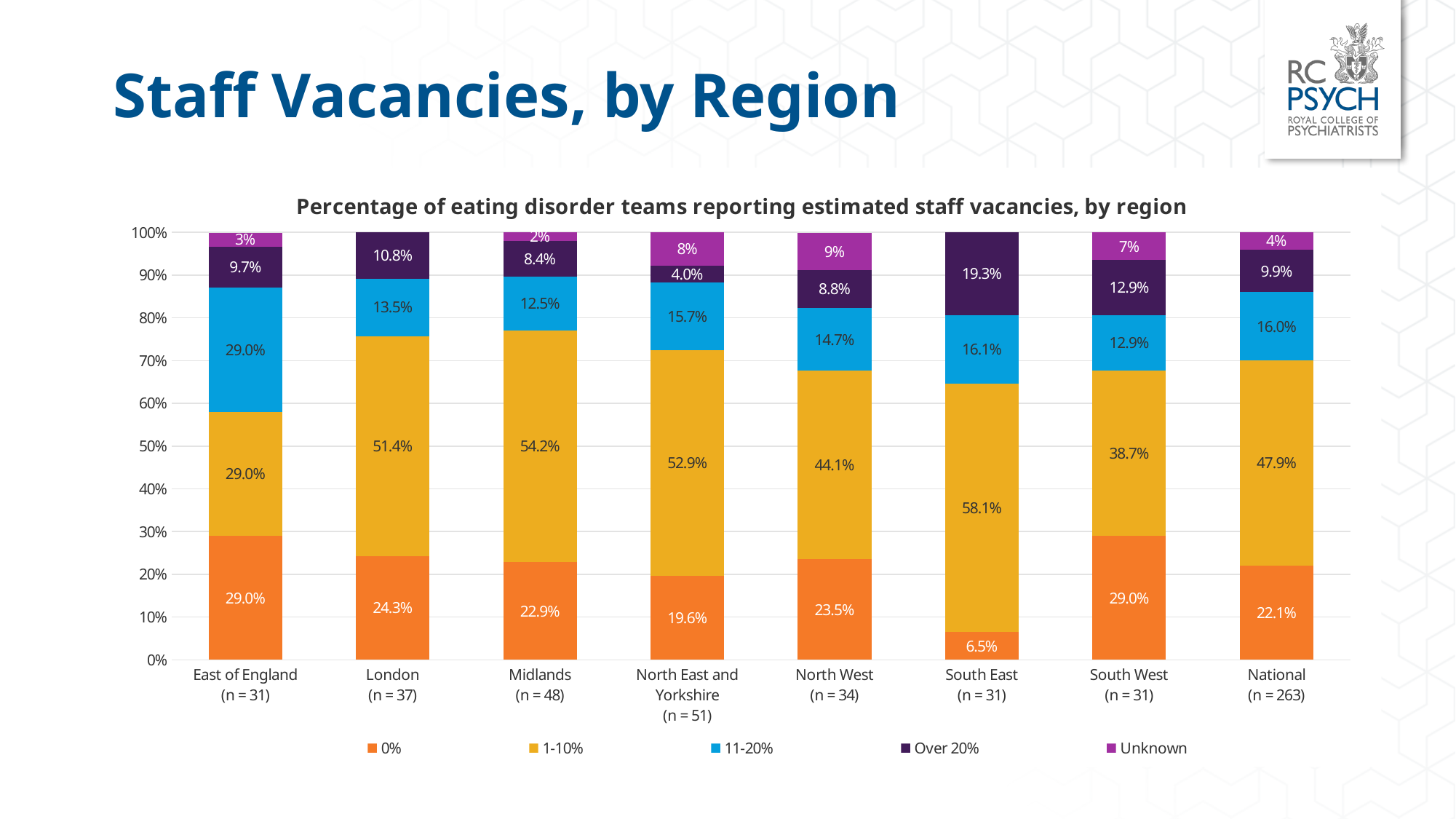
How many series does the legend list? 5 What is the value of the Unknown segment for North East and Yorkshire? 8% Which region has the highest value for the 1-10% vacancy category? South East What is the sample size (n) shown for the National bar? 263 For London, how much larger is the 1-10% segment than the 0% segment, in percentage points? 27.1 Which is larger: the 11-20% value for East of England or the 11-20% value for the Midlands? East of England What percentage of eating disorder teams in London reported 0% staff vacancies? 24.3% What kind of chart is shown on the slide? Stacked bar chart Which region has the lowest value for the 0% vacancy category? South East What percentage of teams in the North West reported vacancies of over 20%? 8.8% What is the value of the 1-10% segment for the South East? 58.1% How many regions (including National) are shown on the x axis? 8